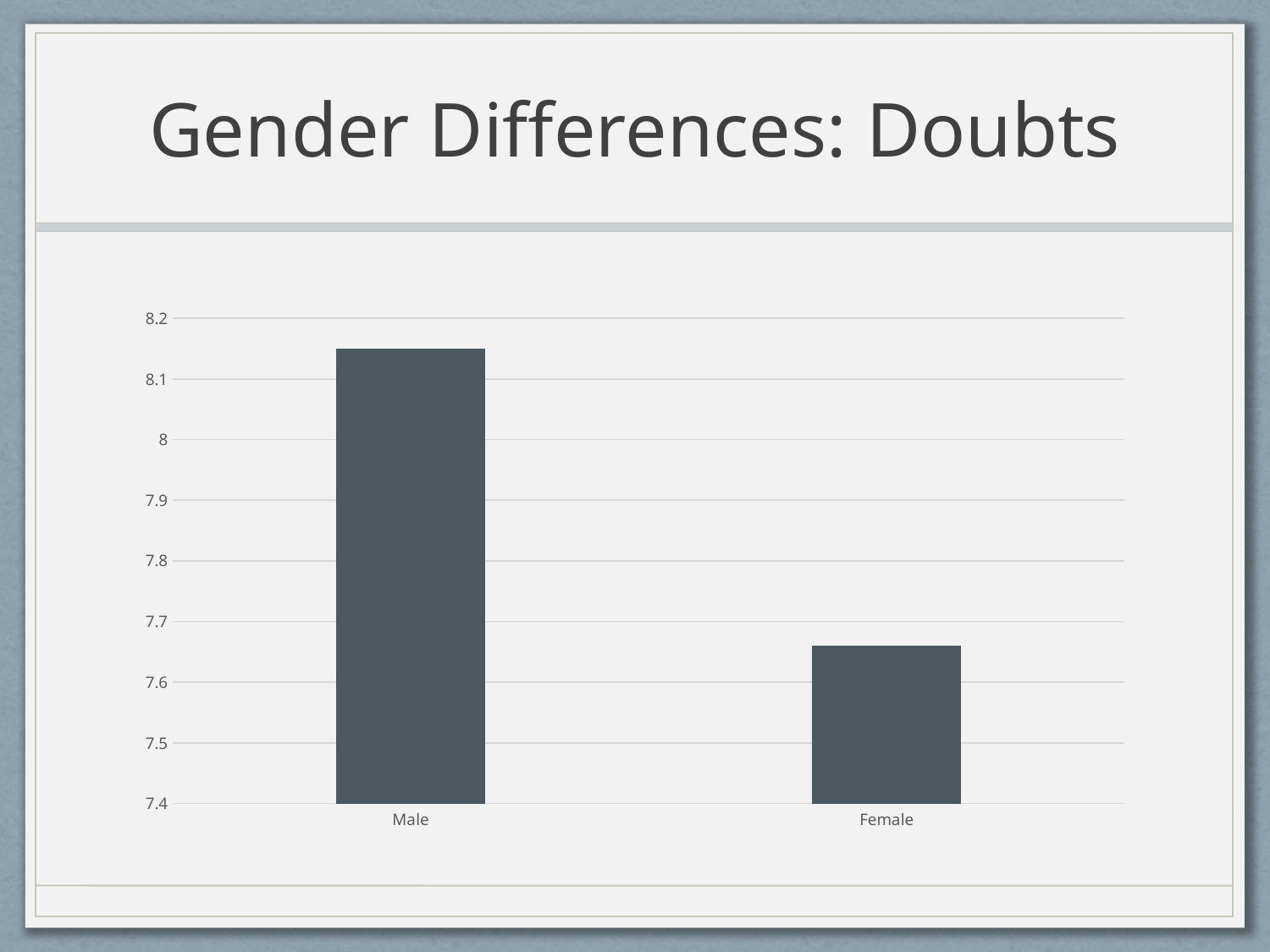
Is the value for Male greater or less than 8.2? less What is the lowest value shown on the vertical axis? 7.4 What kind of chart is shown on the slide? bar chart Which category has the highest value? Male Which is larger, the value for Male or the value for Female? Male What is the title of the slide containing the chart? Gender Differences: Doubts Which category has the lowest value? Female Is the value for Male greater or less than 8? greater How many categories are plotted on the chart? 2 Is the value for Female greater or less than 7.6? greater